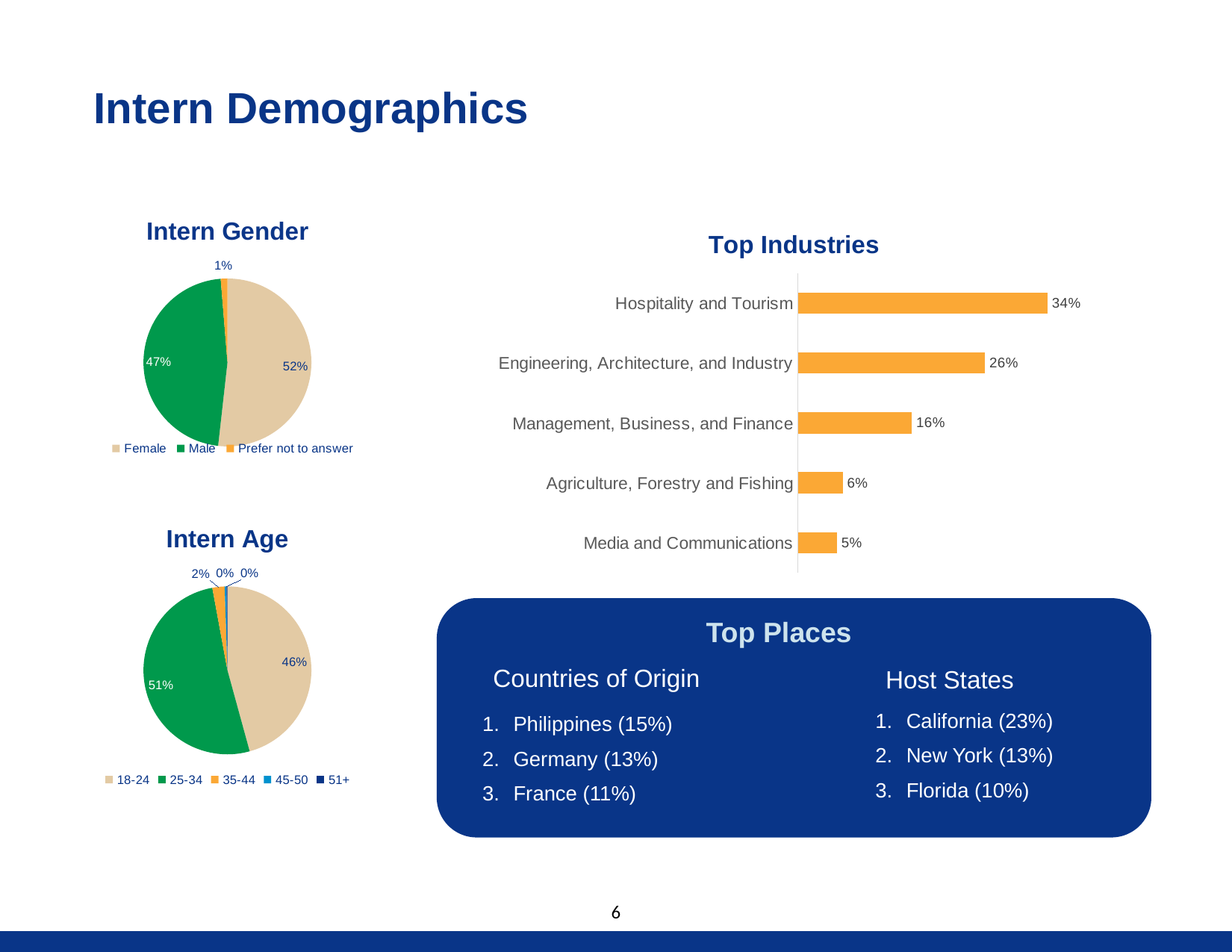
In the Top Industries chart, which industry has the highest value? Hospitality and Tourism In the Intern Gender chart, what percentage chose Prefer not to answer? 1% What kind of chart is the Intern Age chart? Pie chart In the Intern Age chart, which age group has the largest share? 25-34 In the Intern Age chart, what is the share for the 35-44 age group? 2% In the Intern Gender chart, how many categories does the legend list? 3 In the Intern Age chart, what is the difference between the 25-34 and 18-24 shares? 5% In the Top Industries chart, what is the difference between Hospitality and Tourism and Engineering, Architecture, and Industry? 8% In the Intern Age chart, what is the share for the 18-24 age group? 46% In the Top Industries chart, what is the value for Management, Business, and Finance? 16% In the Intern Gender chart, what percentage of interns are Male? 47% In the Intern Gender chart, what percentage of interns are Female? 52%